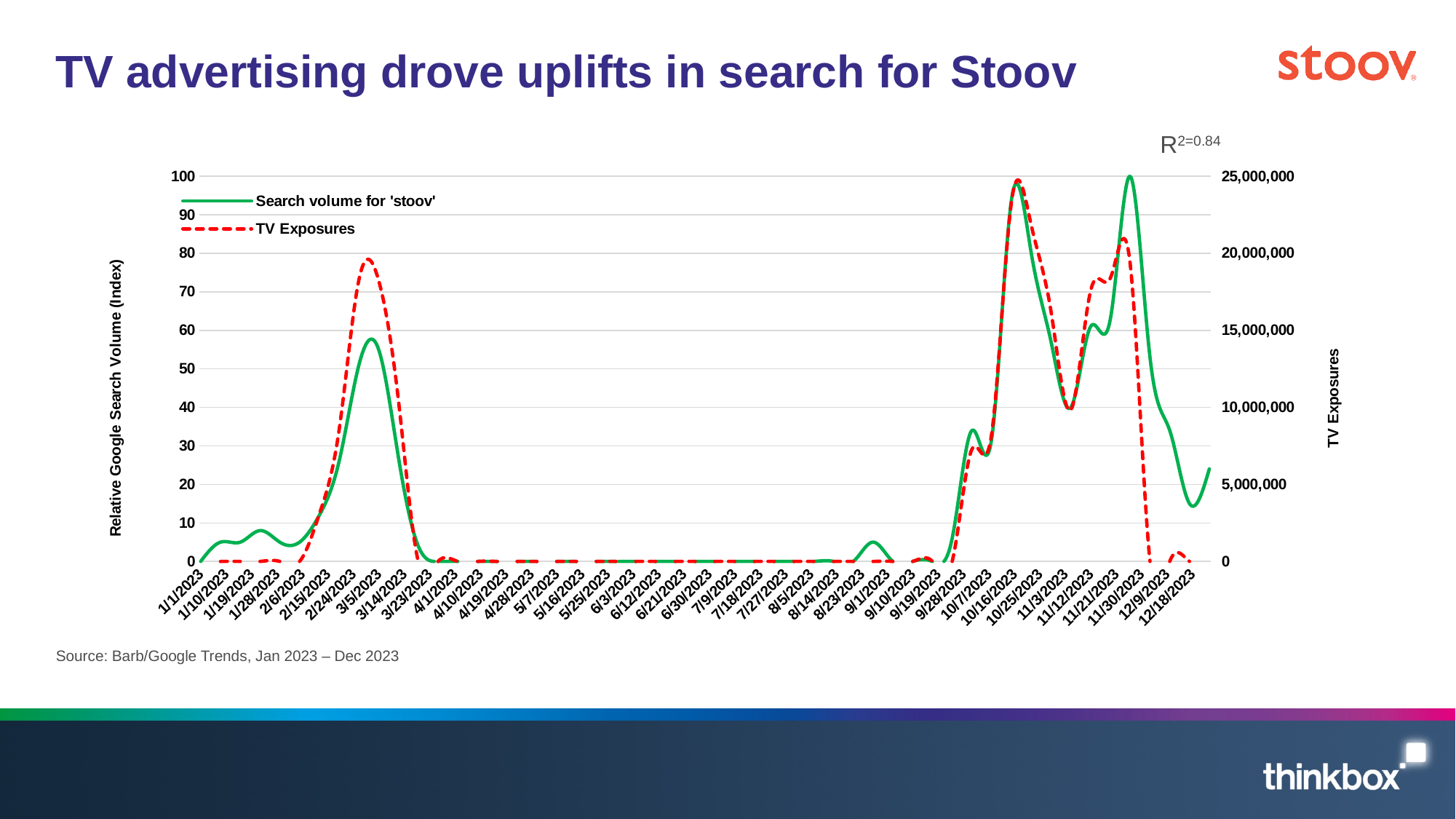
Is the 'TV Exposures' value around 11/12/2023 greater or less than 15,000,000? greater Is the 'Search volume for stoov' value around 6/3/2023 greater or less than 10? less What is the highest value reached by the 'Search volume for stoov' line on the left axis? 100 Is the 'Search volume for stoov' value at its early-March peak (around 3/5/2023) greater or less than 50? greater What kind of chart is shown on the slide? Line chart What R-squared value is shown on the chart? 0.84 Which is higher for 'Search volume for stoov': the peak in early March 2023 or the peak in late November 2023? Late November 2023 Does the 'Search volume for stoov' line rise or fall between 10/16/2023 and 11/3/2023? Fall How many series does the legend list? 2 Around which date label does the 'Search volume for stoov' line reach its peak of 100? 11/30/2023 How many date labels are shown on the x axis? 40